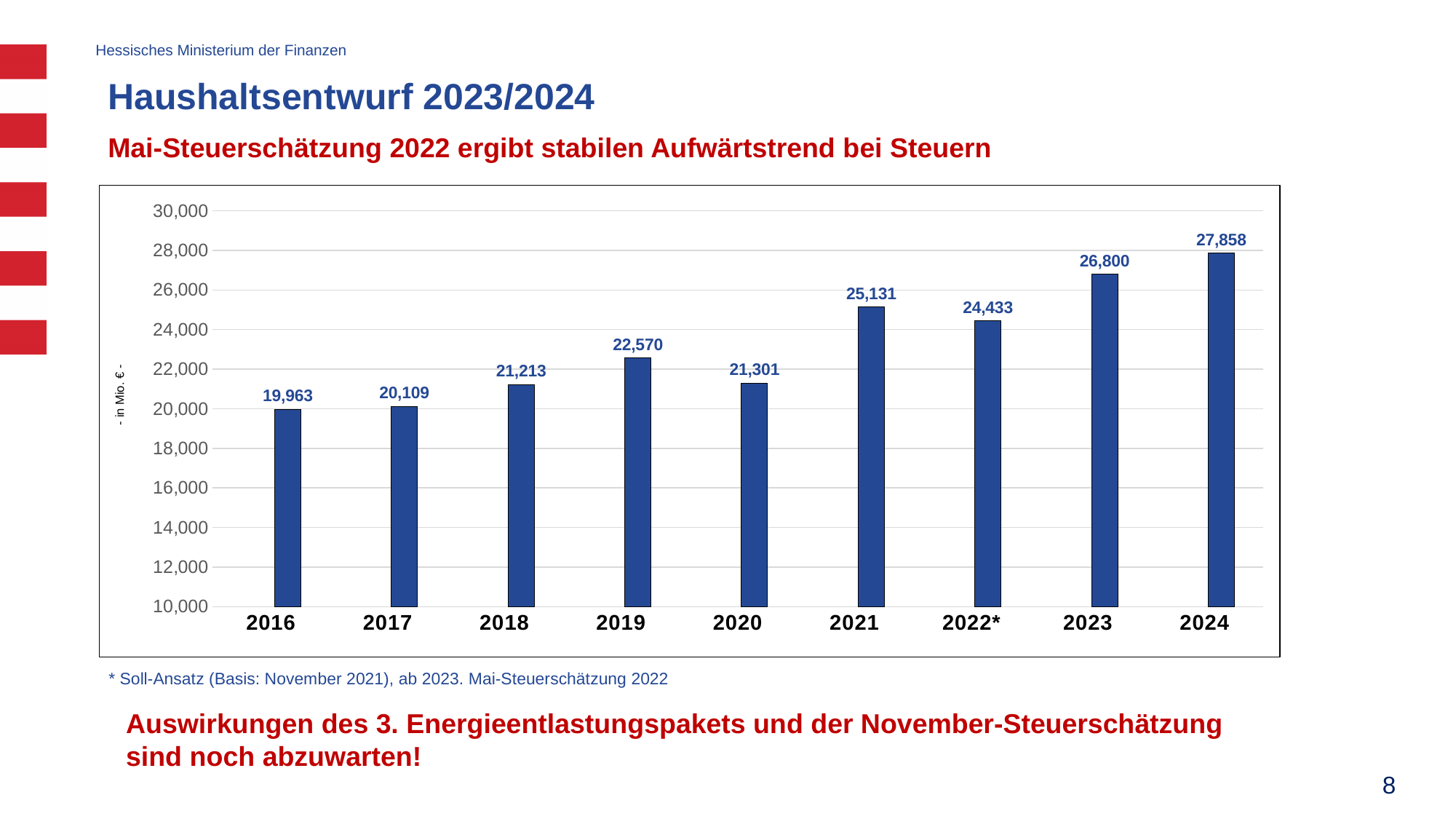
What is the difference between the values for 2021 and 2020? 3,830 What is the value shown for 2019? 22,570 What is the value shown for 2016? 19,963 What is the difference between the values for 2024 and 2023? 1,058 Which year has the highest value? 2024 How many years are shown on the x axis? 9 What is the value shown for 2022*? 24,433 What unit is given on the y axis label? in Mio. € Is the value for 2023 greater or less than 26,000? greater What kind of chart is shown on the slide? bar chart Which is larger, the value for 2021 or the value for 2022*? 2021 Which year has the lowest value? 2016